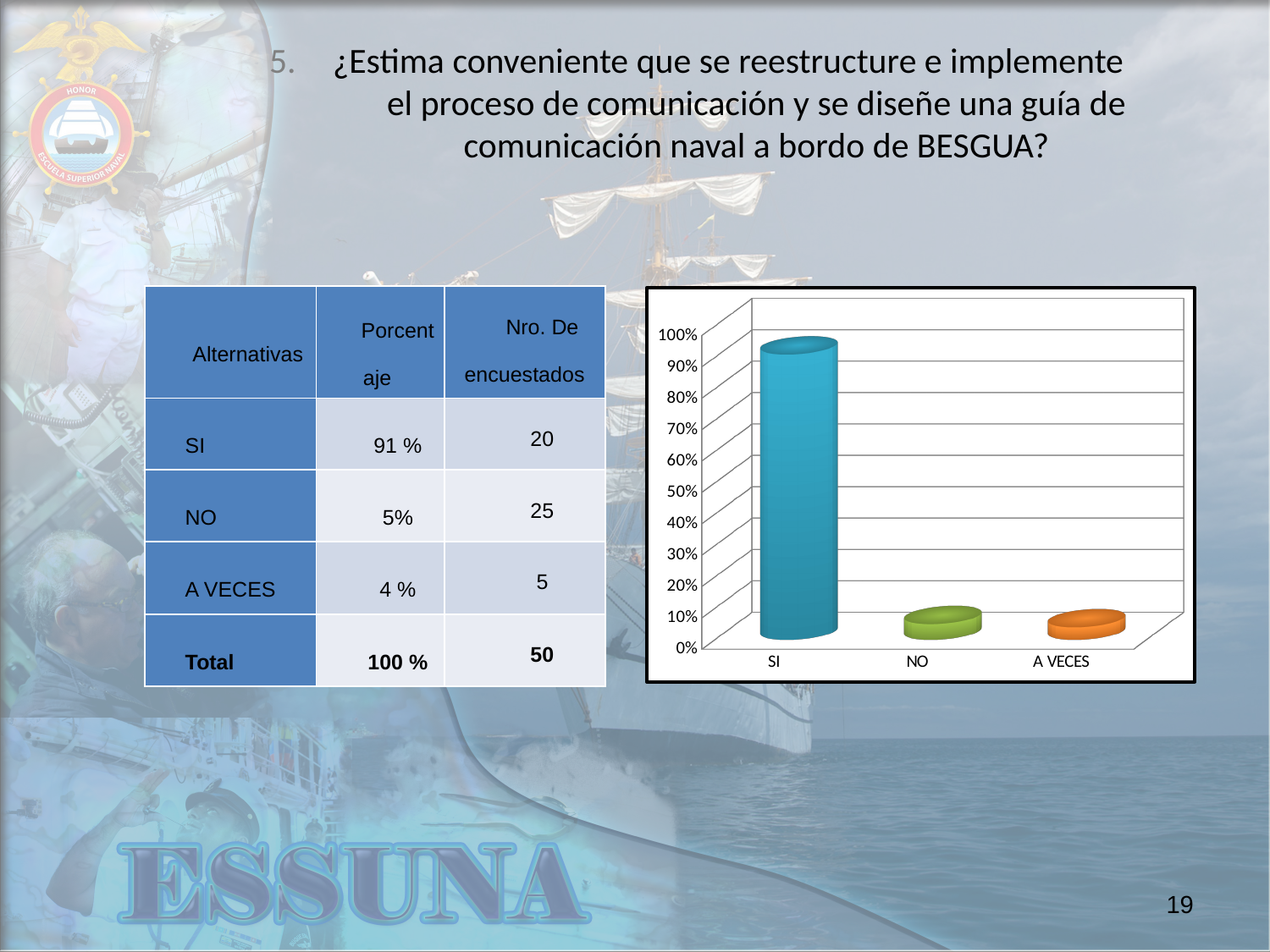
Is the value for SI greater or less than 80%? greater Which bar is taller, SI or NO? SI What kind of chart is shown on the slide? bar chart Which category has the highest bar in the chart? SI What are the category labels on the x axis, from left to right? SI, NO, A VECES What is the highest value shown on the chart's vertical axis? 100% How many categories are shown on the x axis of the chart? 3 Is the value for A VECES greater or less than 20%? less Which bar is taller, A VECES or SI? SI What colour is the bar for SI? blue Is the value for NO greater or less than 10%? less